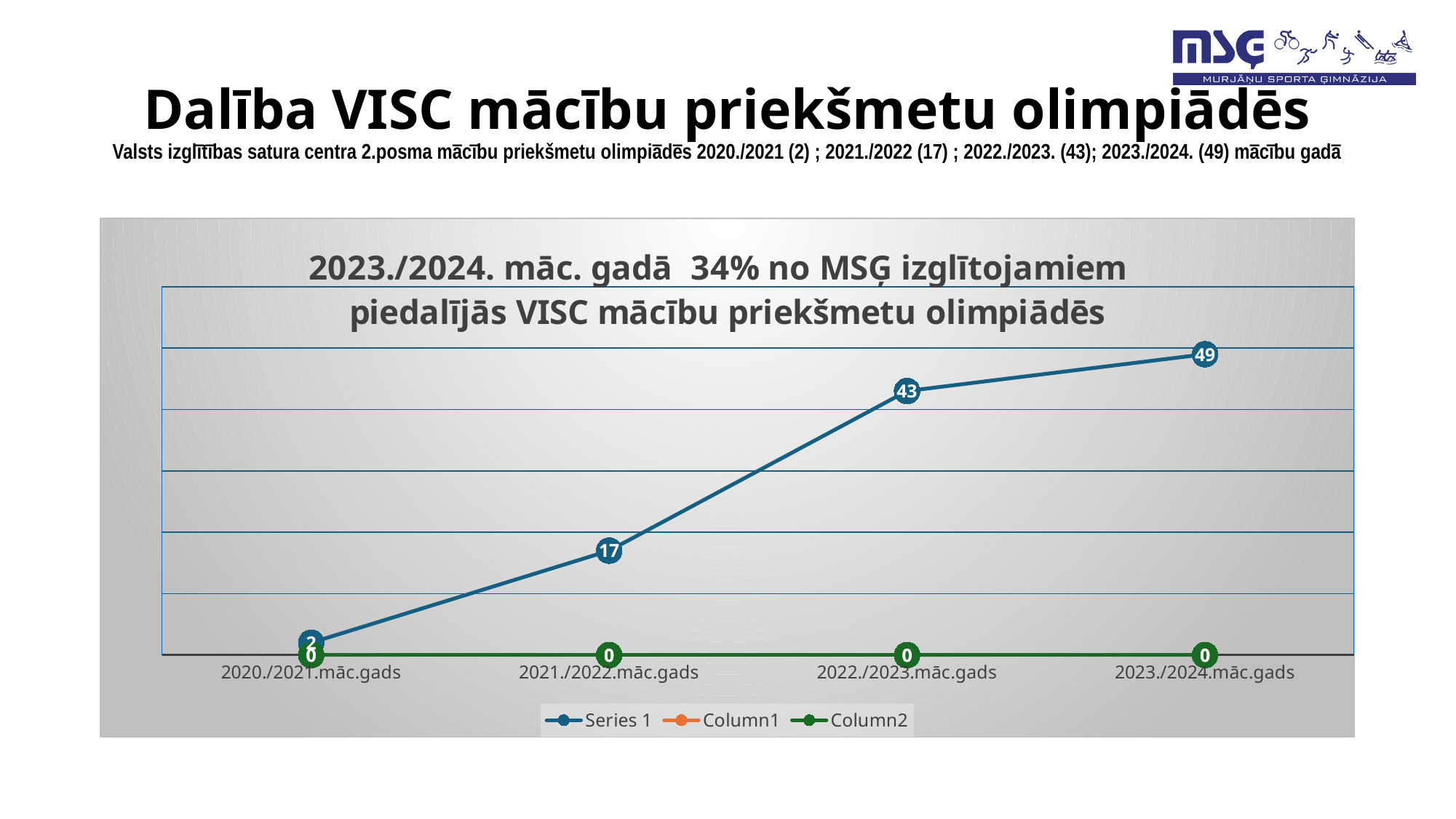
What kind of chart is shown on the slide? line chart What is the value for Series 1 in 2022./2023.māc.gads? 43 Which is larger for Series 1: the value for 2021./2022.māc.gads or 2022./2023.māc.gads? 2022./2023.māc.gads What is the value for Series 1 in 2023./2024.māc.gads? 49 Which school year has the lowest value for Series 1? 2020./2021.māc.gads What is the value for Series 1 in 2020./2021.māc.gads? 2 Which school year has the highest value for Series 1? 2023./2024.māc.gads Do the Series 1 values rise or fall from 2020./2021.māc.gads to 2023./2024.māc.gads? rise What is the value for Series 1 in 2021./2022.māc.gads? 17 How many series does the legend list? 3 How many school years are shown on the x axis? 4 What is the difference between the Series 1 values for 2022./2023.māc.gads and 2021./2022.māc.gads? 26